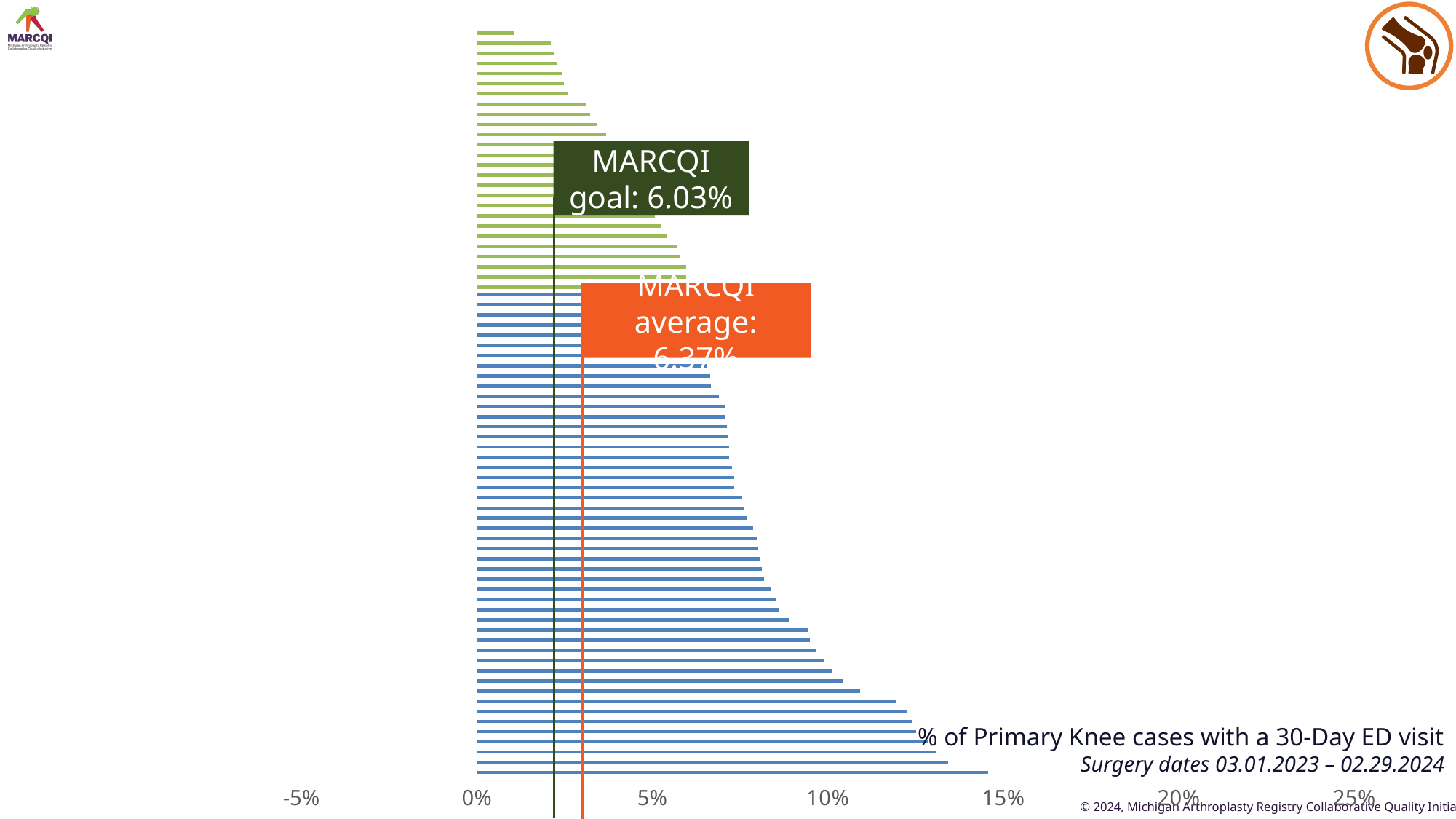
Is the value of the longest bar greater or less than 10%? greater What MARCQI average value is printed on the chart? 6.37% Is the value of the shortest non-zero bar greater or less than 5%? less What MARCQI goal value is printed on the chart? 6.03% What is the highest tick label shown on the horizontal axis? 25% Is the value of the longest bar greater or less than 15%? less Which is larger, the MARCQI goal or the MARCQI average? MARCQI average What surgery date range is stated below the chart title? 03.01.2023 – 02.29.2024 What is the title of the chart? % of Primary Knee cases with a 30-Day ED visit What kind of chart is shown on the slide? bar chart What is the difference between the MARCQI average (6.37%) and the MARCQI goal (6.03%)? 0.34% Do the bar values increase or decrease going from the top of the chart to the bottom? increase